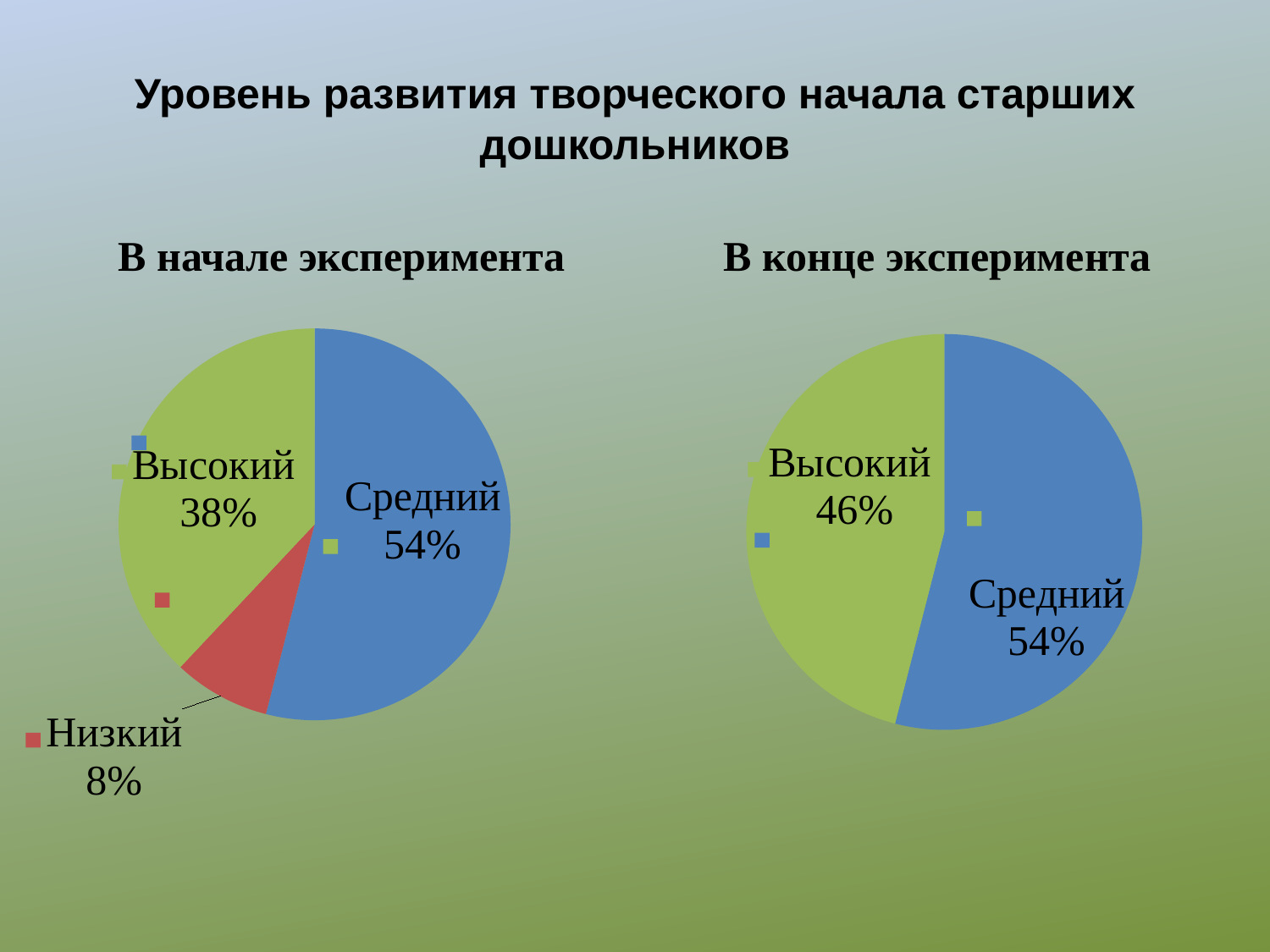
In the "В конце эксперимента" chart, what is the value for Высокий? 46% In the "В начале эксперимента" chart, what is the difference between Средний and Высокий? 16% In the "В конце эксперимента" chart, what is the value for Средний? 54% In the "В конце эксперимента" chart, which is larger, Средний or Высокий? Средний In the "В начале эксперимента" chart, what is the value for Средний? 54% In the "В конце эксперимента" chart, how many slices does the pie have? 2 What kind of chart is shown under "В начале эксперимента"? pie chart In the "В начале эксперимента" chart, what is the value for Высокий? 38% In the "В начале эксперимента" chart, how many slices does the pie have? 3 In the "В начале эксперимента" chart, what is the value for Низкий? 8% In the "В начале эксперимента" chart, which category has the smallest slice? Низкий In the "В начале эксперимента" chart, which category has the largest slice? Средний